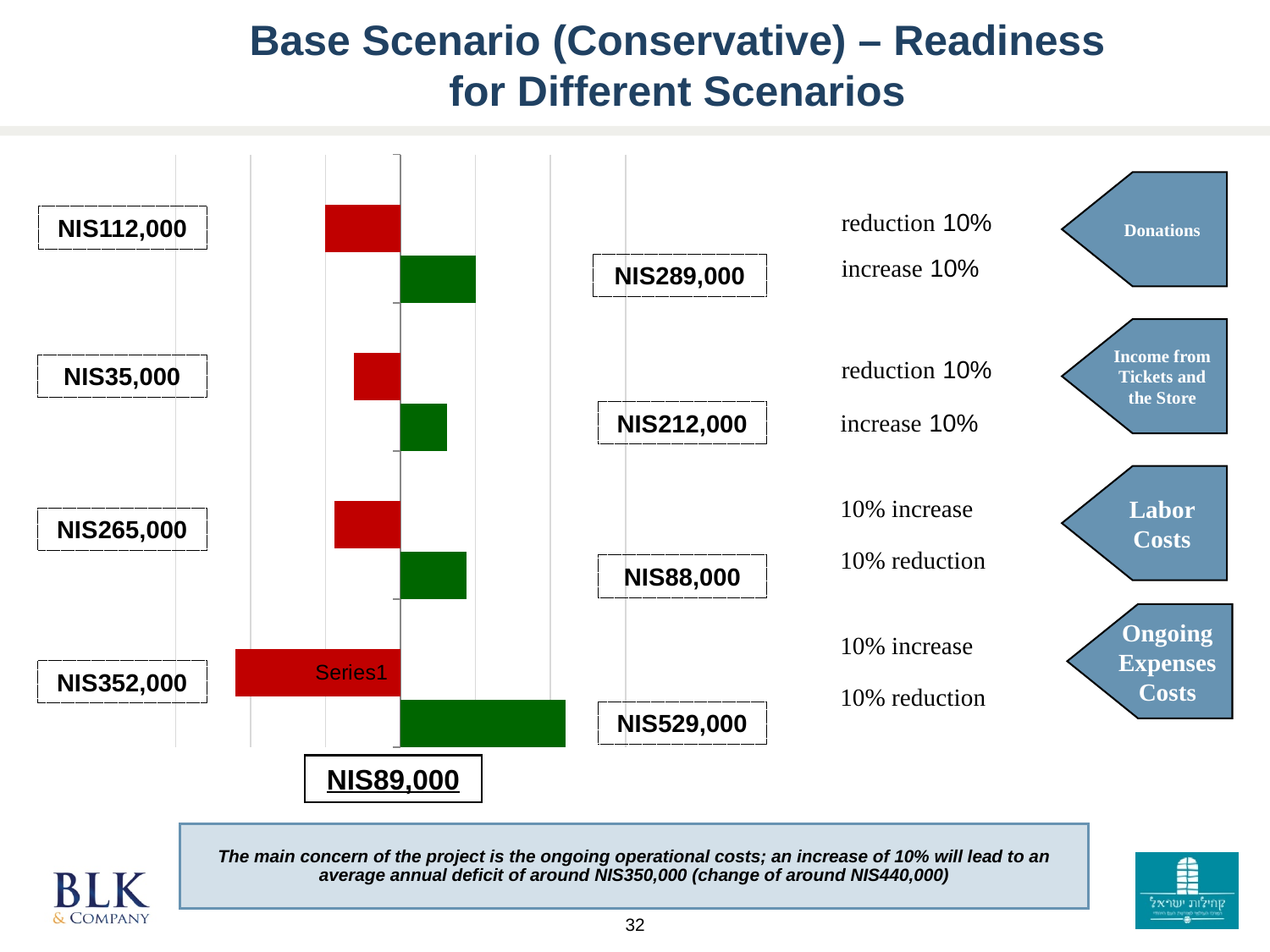
What is the value shown for a 10% increase in Donations? NIS289,000 What kind of chart is shown on the slide? bar chart Which category has the shortest red bar? Income from Tickets and the Store What is the difference between the 10% reduction value (NIS529,000) and the 10% increase value (NIS352,000) for Ongoing Expenses Costs? NIS177,000 What is the value shown for a 10% increase in Labor Costs? NIS265,000 What base value is shown underlined below the chart? NIS89,000 How many categories (scenario groups) are shown in the chart? 4 What is the value shown for a 10% increase in Income from Tickets and the Store? NIS212,000 What is the value shown for a 10% reduction in Ongoing Expenses Costs? NIS529,000 What is the value shown for a 10% reduction in Donations? NIS112,000 Which is larger: the 10% increase value for Donations or the 10% increase value for Income from Tickets and the Store? Donations (NIS289,000) Which category has the longest red bar? Ongoing Expenses Costs